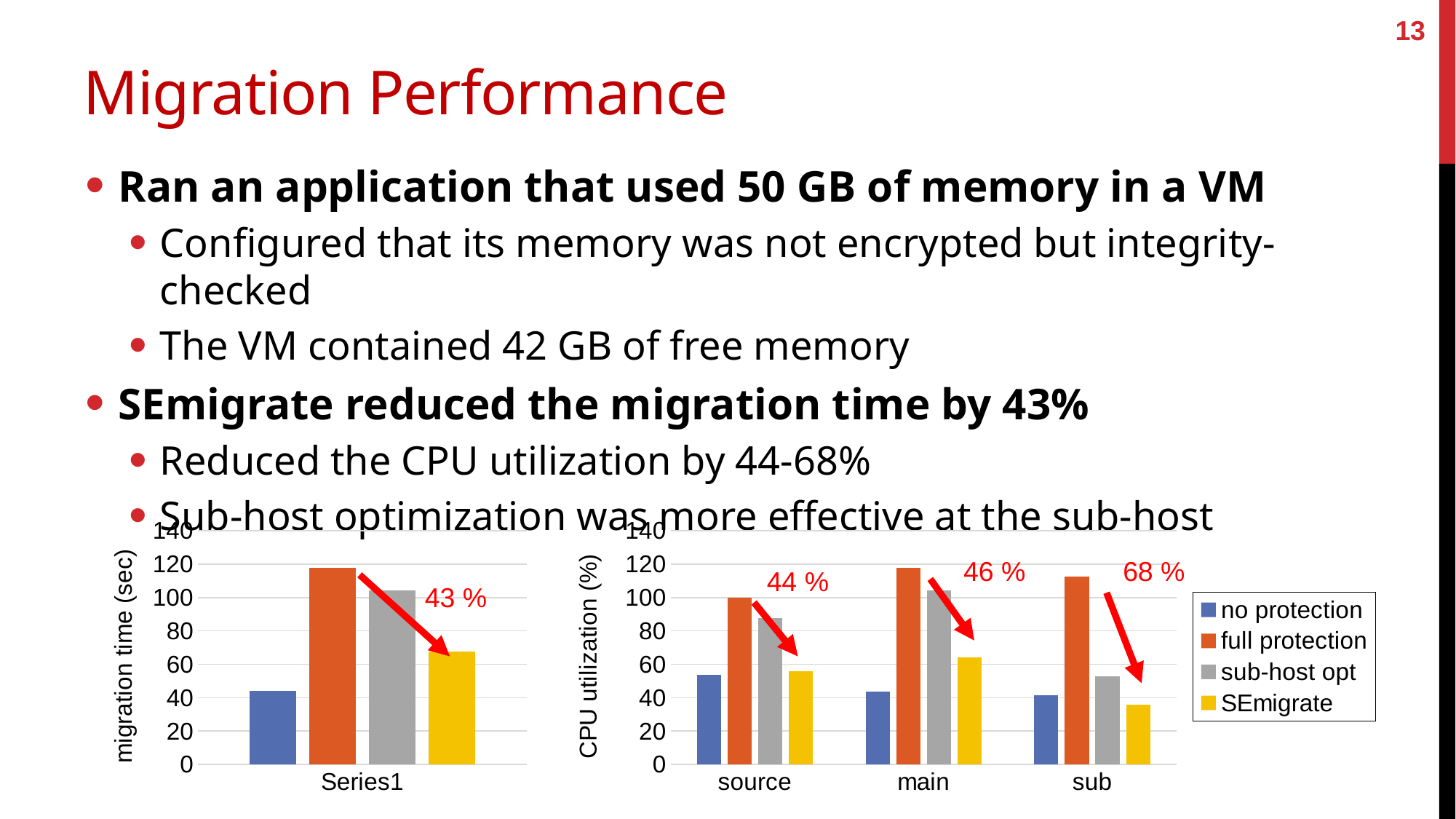
In the right chart (CPU utilization), which series has the highest bar for main? full protection In the left chart (migration time), which series has the lowest bar? no protection In the right chart (CPU utilization), which series has the lowest bar for main? no protection What kind of chart is the left chart (migration time)? bar chart What percentage reduction is annotated above the SEmigrate bar for sub in the right chart? 68 % How many series does the legend list? 4 In the left chart (migration time), is the value for full protection greater or less than 100? greater In the left chart (migration time), is the value for no protection greater or less than 60? less In the right chart (CPU utilization), is the sub-host opt value larger for source or for sub? source How many categories are shown on the x axis of the right chart (CPU utilization)? 3 In the right chart (CPU utilization), is the value for full protection at main greater or less than 100? greater In the left chart (migration time), which series has the highest bar? full protection